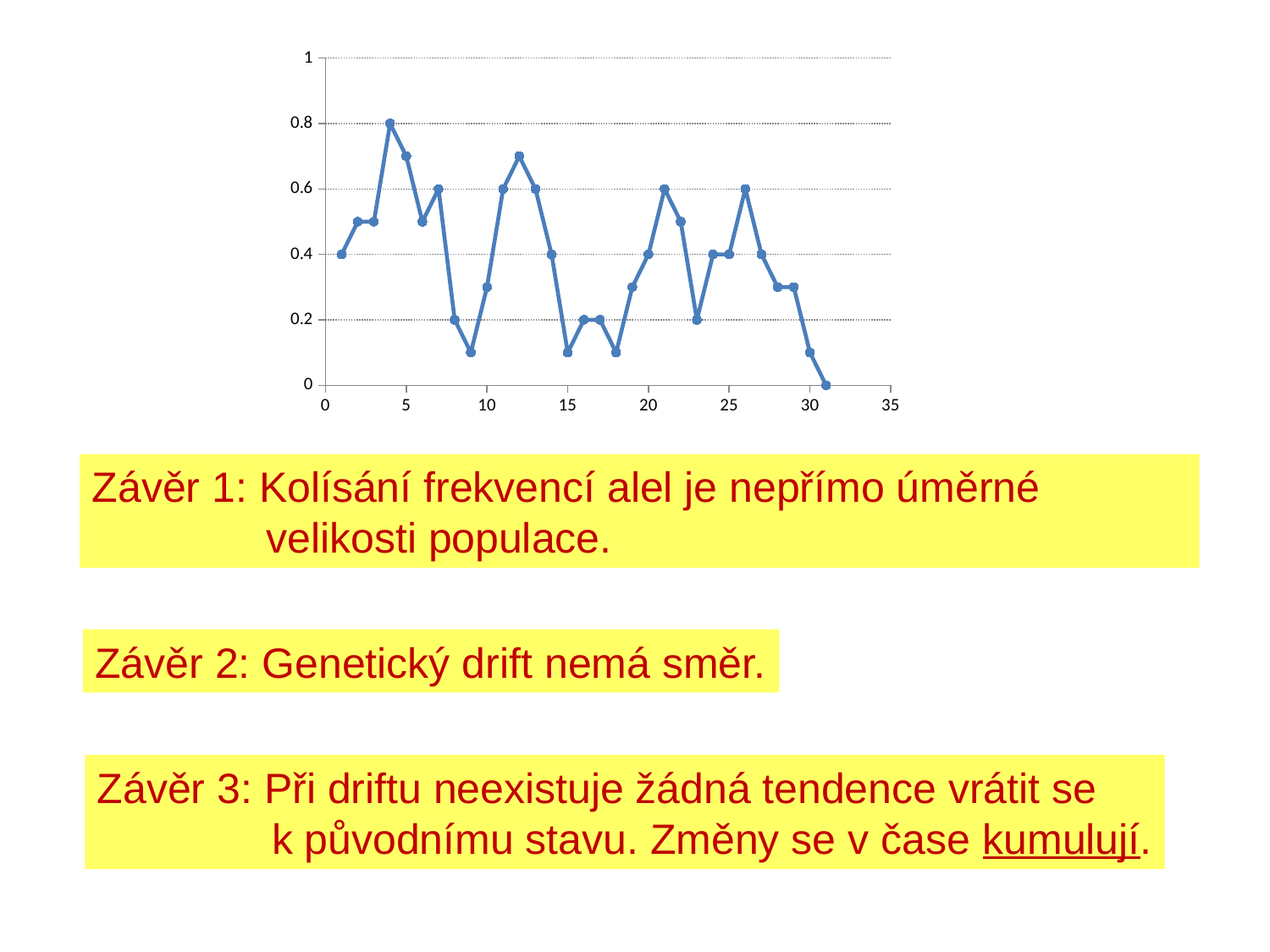
At which x value does the line reach its highest point? 4 What is the value of the last point on the line (at x = 31)? 0 Comparing the first point and the last point, does the line overall rise or fall along the x axis? fall How many data points are plotted on the line? 31 What kind of chart is shown on the slide? line chart At which x value does the line reach its lowest point? 31 Which is larger, the value at x = 4 or the value at x = 8? x = 4 What is the value of the first point on the line (at x = 1)? 0.4 What is the value at x = 4? 0.8 Is the value at x = 12 greater or less than 0.6? greater What is the highest value reached by the line? 0.8 Is the value at x = 9 greater or less than 0.2? less